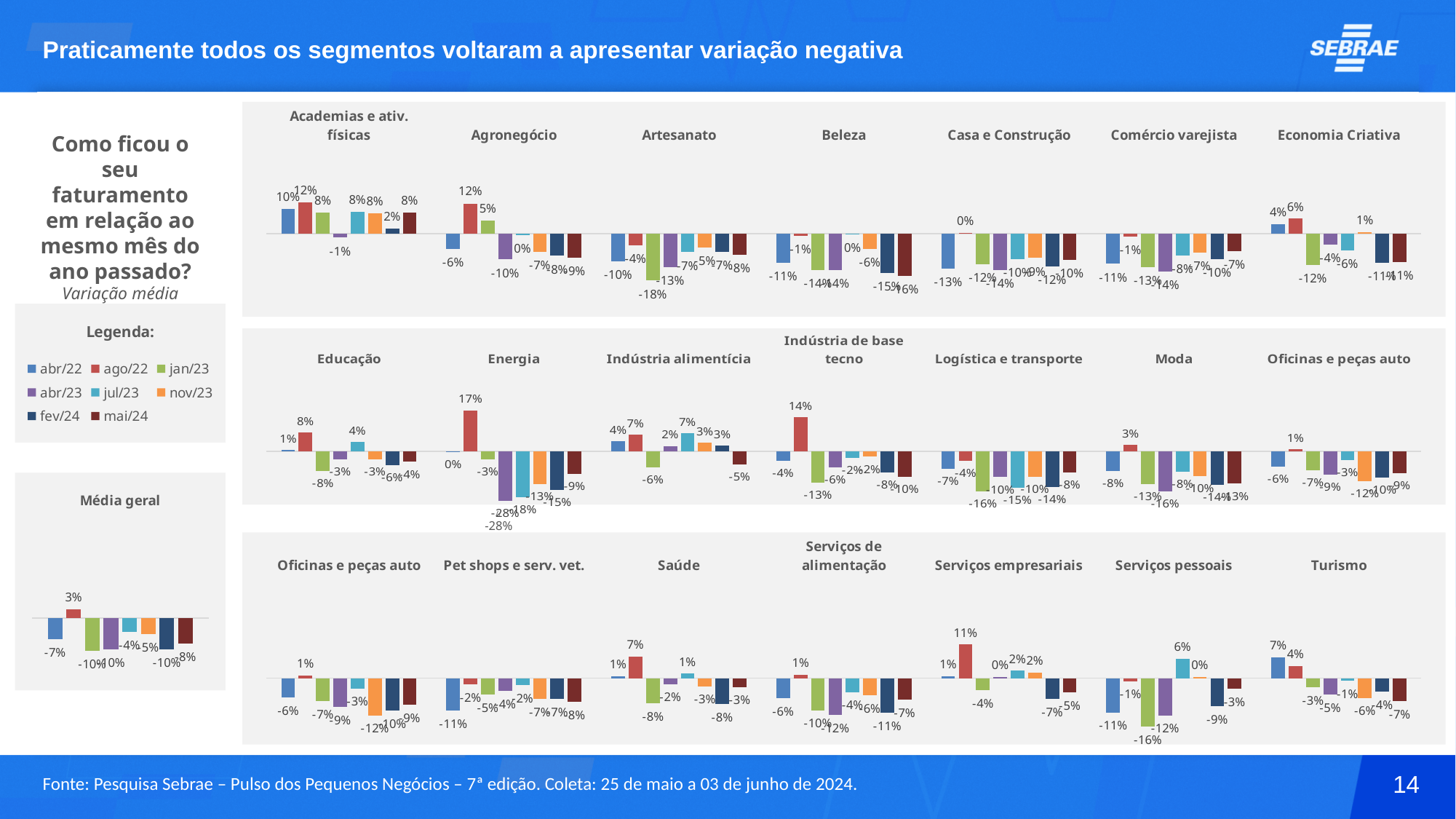
In the 'Energia' chart, which series has the highest value? ago/22 In the 'Serviços pessoais' chart, what is the value for jul/23? 6% In the 'Beleza' chart, what is the value for mai/24? -16% In the 'Turismo' chart, which is larger, the value for abr/22 or the value for ago/22? abr/22 In the 'Academias e ativ. físicas' chart, what is the difference between the ago/22 value and the mai/24 value? 4 percentage points In the 'Média geral' chart, what is the value for mai/24? -8% How many series does the legend list? 8 What kind of chart is the 'Média geral' chart? bar chart In the 'Média geral' chart, what is the value for ago/22? 3% In the 'Energia' chart, what is the value for ago/22? 17% In the 'Indústria de base tecno' chart, what is the value for ago/22? 14% In the 'Artesanato' chart, which series has the lowest value? jan/23